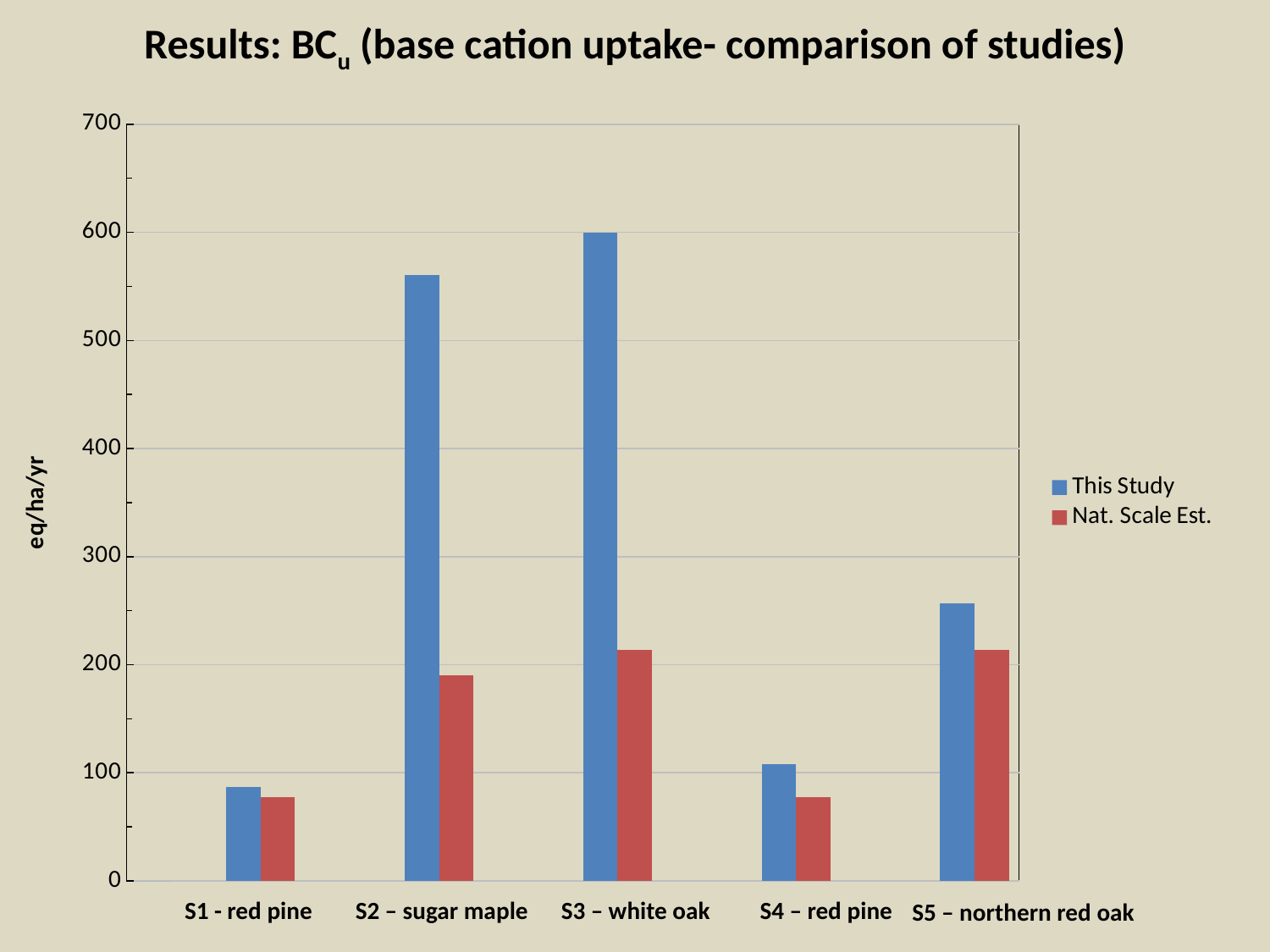
For S2 – sugar maple, which is larger: This Study or Nat. Scale Est.? This Study Is the Nat. Scale Est. value for S3 – white oak greater or less than 200? greater How many series does the legend list? 2 Which is larger for This Study: S2 – sugar maple or S5 – northern red oak? S2 – sugar maple How many site categories are shown on the x axis? 5 What is the label on the y axis? eq/ha/yr Is the This Study value for S5 – northern red oak greater or less than 300? less Is the This Study value for S2 – sugar maple greater or less than 500? greater What kind of chart is shown on the slide? bar chart Which site has the highest value for This Study? S3 – white oak Which site has the lowest value for This Study? S1 - red pine